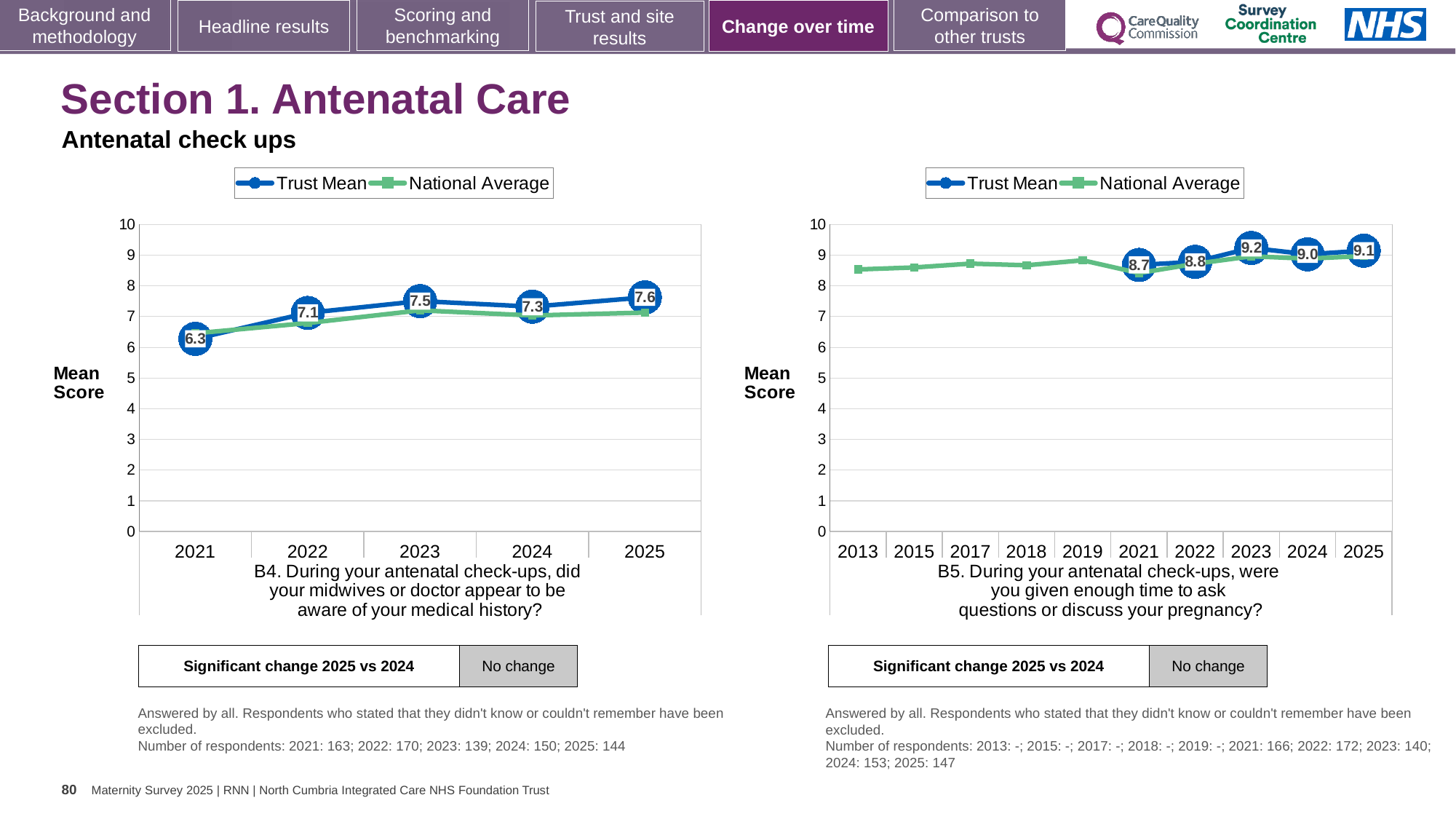
What type of chart is the left chart (B4)? Line chart In the left chart (B4), what is the Trust Mean value for 2021? 6.3 In the right chart (B5), what is the Trust Mean value for 2023? 9.2 In the left chart (B4), how many years are shown on the x axis? 5 In the right chart (B5), how many years are shown on the x axis? 10 In the left chart (B4), what is the difference between the Trust Mean in 2025 and in 2021? 1.3 How many series does the legend of the right chart (B5) list? 2 In the left chart (B4), what is the Trust Mean value for 2025? 7.6 In the right chart (B5), which year has the highest Trust Mean? 2023 In the left chart (B4), which year has the lowest Trust Mean? 2021 In the right chart (B5), is the Trust Mean higher in 2022 or in 2024? 2024 In the left chart (B4), is the National Average value for 2025 greater or less than 6? greater